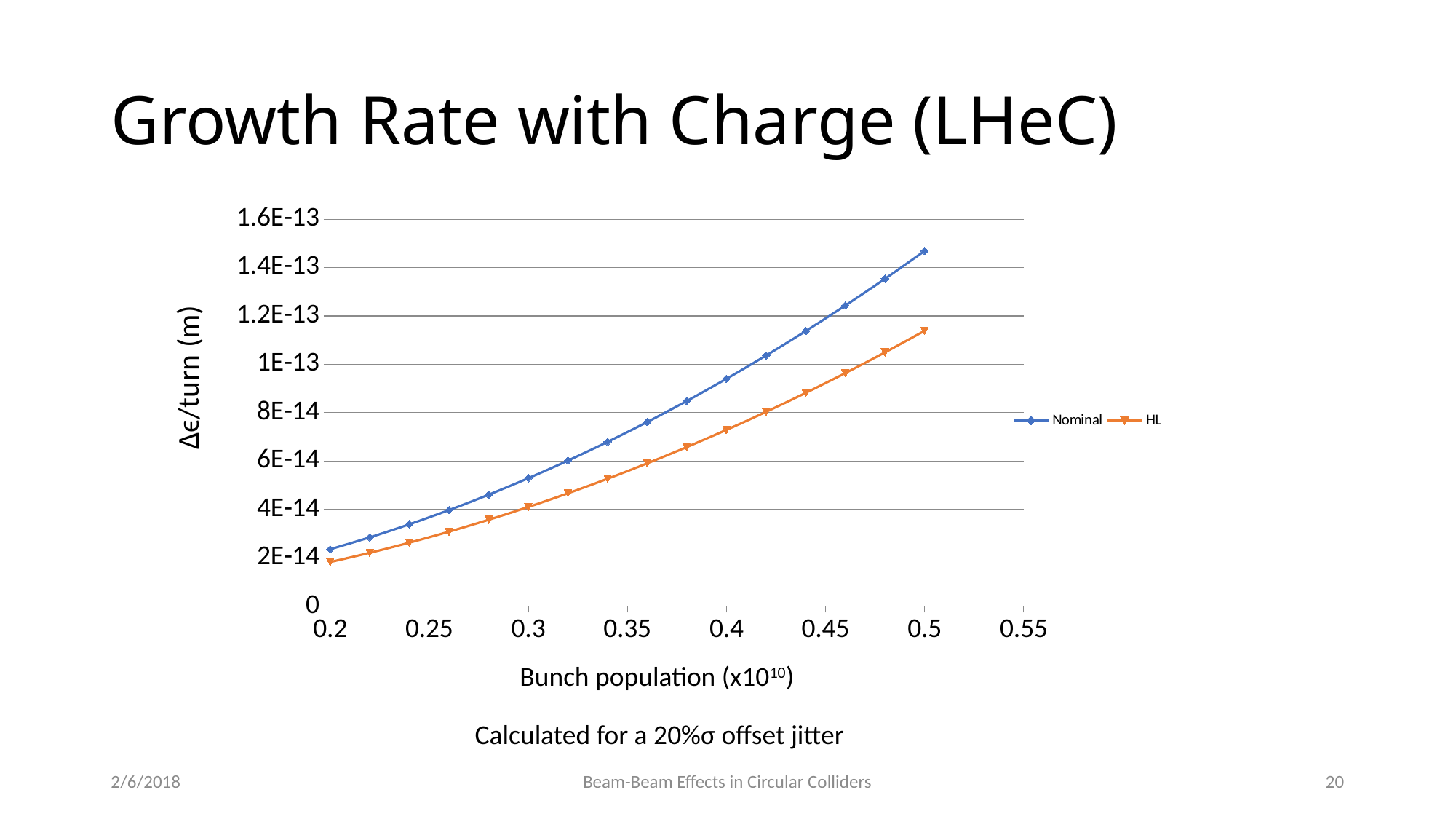
Is the value for the HL series at a bunch population of 0.5 greater or less than 1.2E-13? less What are the names of the two series in the legend? Nominal and HL Do the values of the HL series rise or fall as bunch population increases? rise How many series does the legend list? 2 How many data points are plotted for the Nominal series? 16 Is the value for the Nominal series at a bunch population of 0.4 greater or less than 1E-13? less Is the value for the Nominal series at a bunch population of 0.5 greater or less than 1.4E-13? greater What is the label of the x axis? Bunch population (x10^10) Do the values of the Nominal series rise or fall as bunch population increases? rise Which series reaches the highest value on the chart? Nominal What kind of chart is shown on the slide? line chart Which series has the higher value at a bunch population of 0.5? Nominal